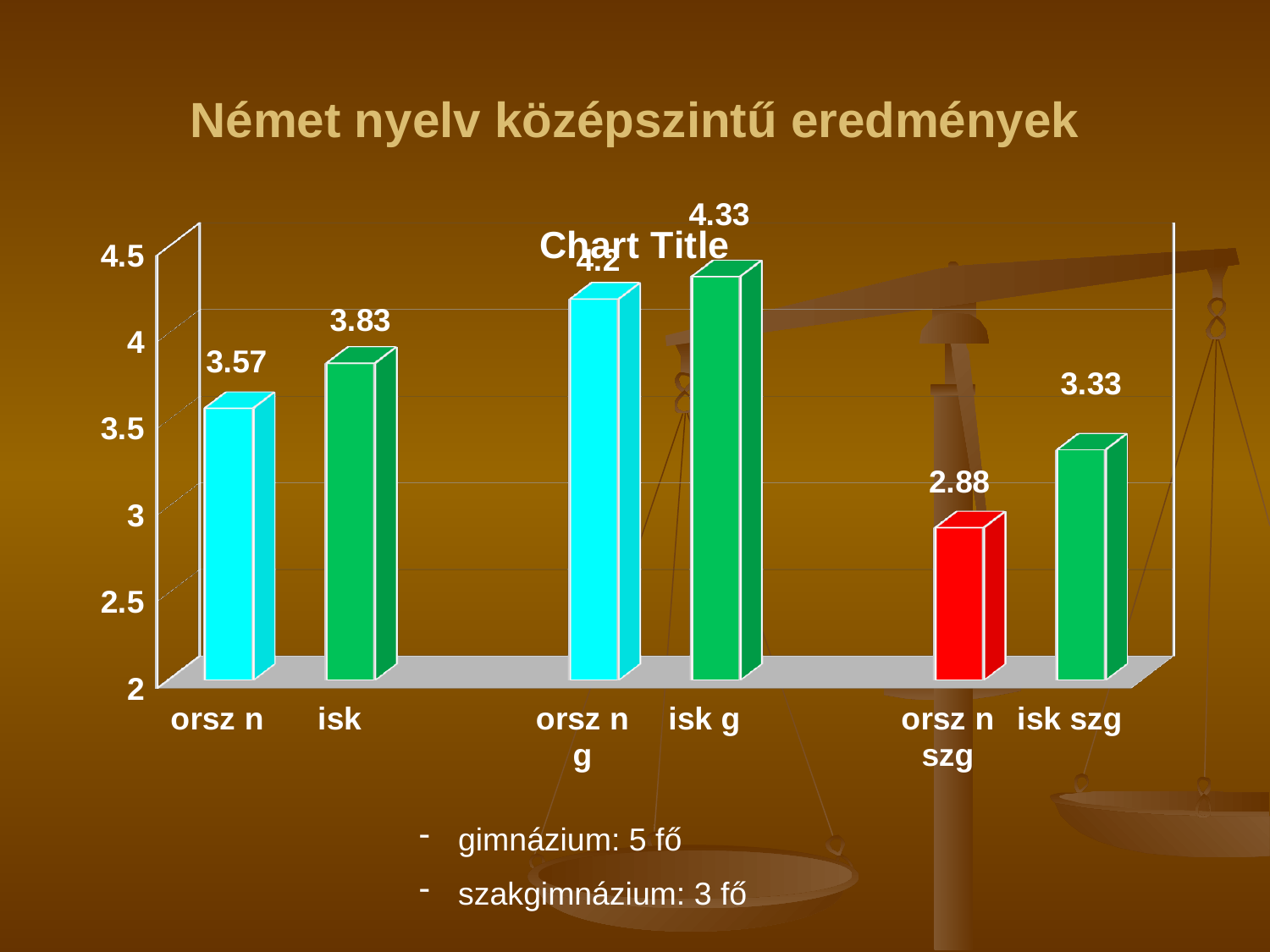
What is the value for "orsz n szg"? 2.88 Which category has the lowest value? orsz n szg What is the value for "orsz n"? 3.57 Is the value for "orsz n szg" greater or less than 3? less How many bars are shown in the chart? 6 What is the value for "isk g"? 4.33 Which category has the highest value? isk g Which is larger, the value for "orsz n g" or the value for "isk g"? isk g What kind of chart is shown on the slide? bar chart What is the difference between the values for "isk" and "orsz n"? 0.26 What is the value for "isk szg"? 3.33 What is the difference between the values for "isk szg" and "orsz n szg"? 0.45